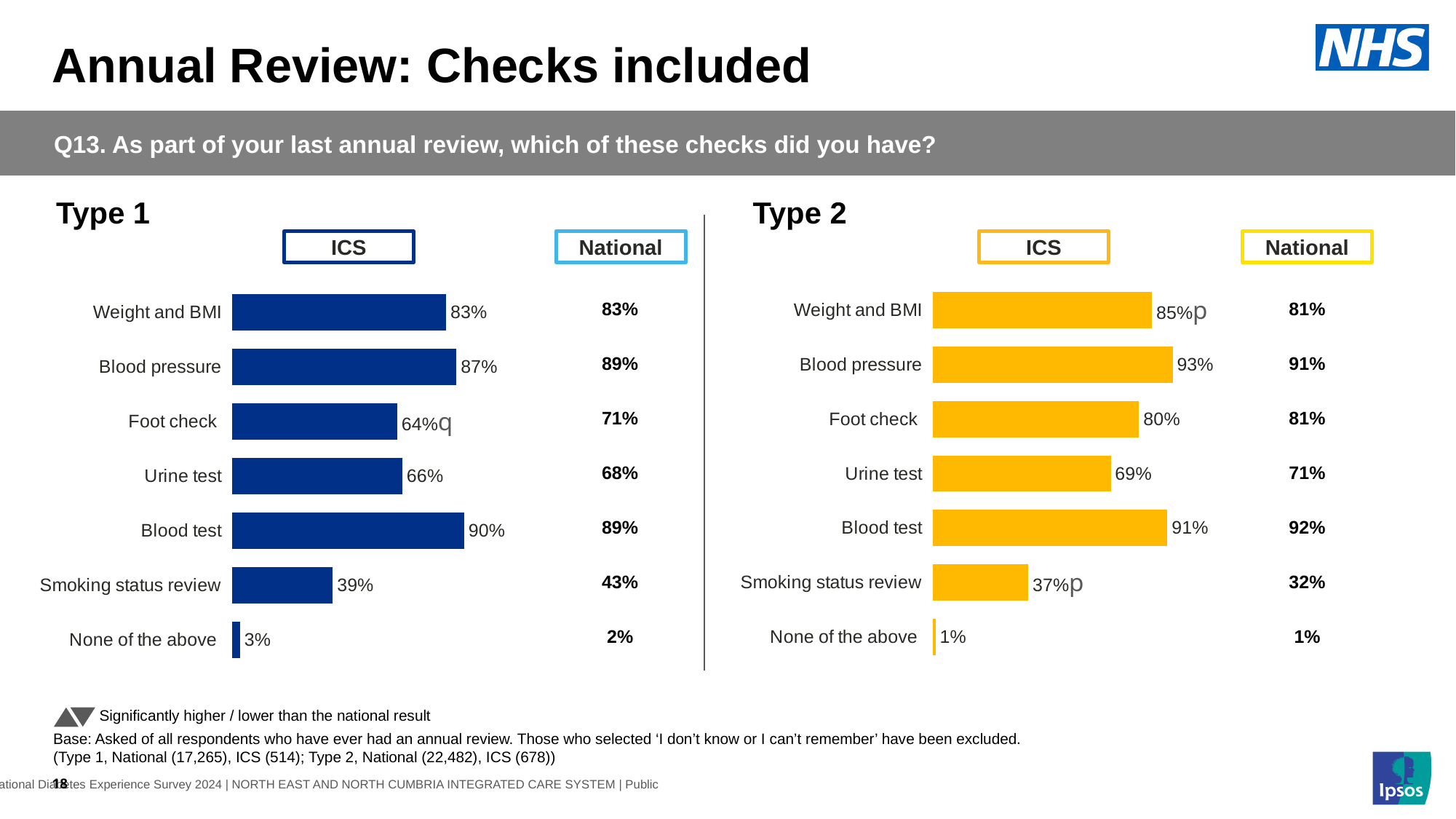
In the Type 2 chart, what is the ICS value for Blood pressure? 93% In the Type 2 chart, what is the National value for Weight and BMI? 81% In the Type 1 chart, what is the ICS value for Foot check? 64% In the Type 2 chart, is the ICS value for Urine test higher or lower than the National value? lower In the Type 1 chart, which check has the highest ICS value? Blood test What type of chart is used for the Type 2 ICS results? bar chart In the Type 2 chart, what is the difference between the ICS and National values for Smoking status review? 5 percentage points What colour are the bars in the Type 2 chart? yellow In the Type 1 chart, what is the difference between the National and ICS values for Foot check? 7 percentage points In the Type 1 chart, what is the National value for Smoking status review? 43% In the Type 2 chart, which check has the lowest ICS value? None of the above How many checks are listed in the Type 1 chart? 7